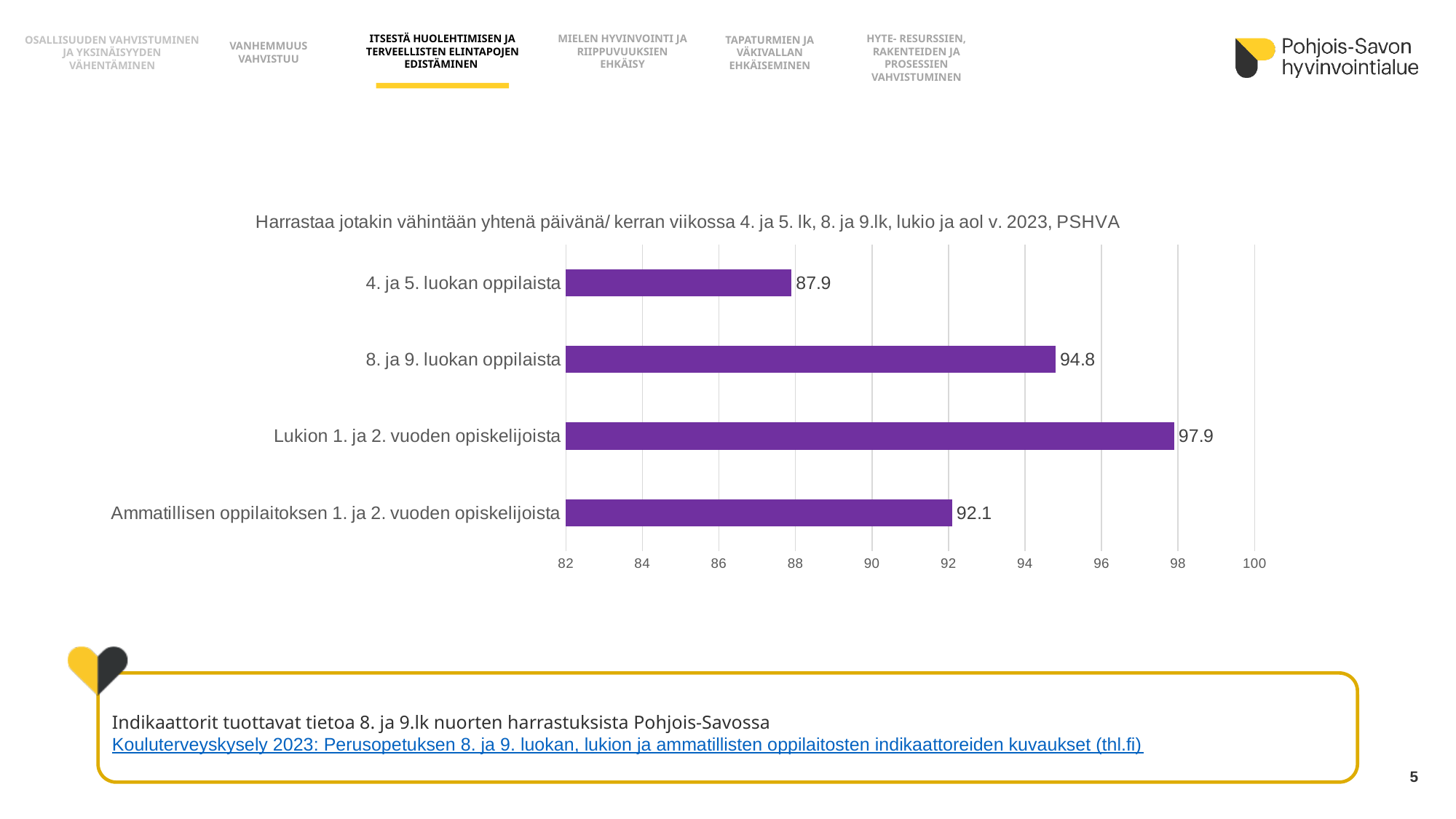
What is the difference between the values for Lukion 1. ja 2. vuoden opiskelijoista and 4. ja 5. luokan oppilaista? 10 What is the title of the chart? Harrastaa jotakin vähintään yhtenä päivänä/ kerran viikossa 4. ja 5. lk, 8. ja 9.lk, lukio ja aol v. 2023, PSHVA Which is larger, the value for 8. ja 9. luokan oppilaista or the value for Ammatillisen oppilaitoksen 1. ja 2. vuoden opiskelijoista? 8. ja 9. luokan oppilaista What is the value for Ammatillisen oppilaitoksen 1. ja 2. vuoden opiskelijoista? 92.1 How many categories are shown in the chart? 4 What is the difference between the values for 8. ja 9. luokan oppilaista and Ammatillisen oppilaitoksen 1. ja 2. vuoden opiskelijoista? 2.7 What kind of chart is shown on the slide? bar chart Which category has the highest value? Lukion 1. ja 2. vuoden opiskelijoista What is the value for 4. ja 5. luokan oppilaista? 87.9 Which category has the lowest value? 4. ja 5. luokan oppilaista Is the value for 4. ja 5. luokan oppilaista greater or less than 90? less What is the value for Lukion 1. ja 2. vuoden opiskelijoista? 97.9